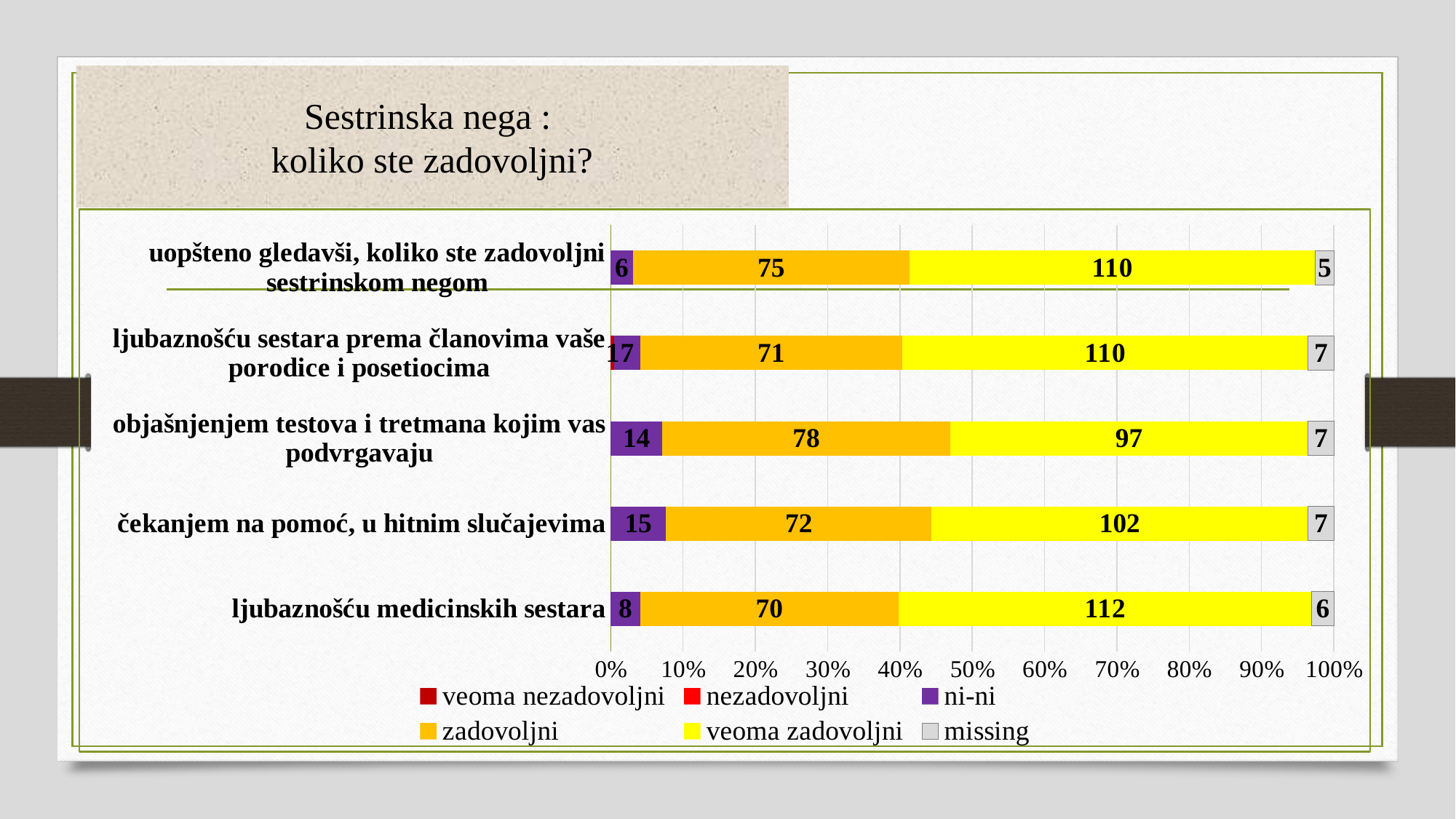
What is the 'missing' value for 'uopšteno gledavši, koliko ste zadovoljni sestrinskom negom'? 5 Which category has the lowest 'veoma zadovoljni' value? objašnjenjem testova i tretmana kojim vas podvrgavaju What is the value of 'zadovoljni' for 'objašnjenjem testova i tretmana kojim vas podvrgavaju'? 78 What is the difference between the 'zadovoljni' values for 'objašnjenjem testova i tretmana kojim vas podvrgavaju' and 'ljubaznošću medicinskih sestara'? 8 How many categories are shown on the chart? 5 What is the 'ni-ni' value for 'čekanjem na pomoć, u hitnim slučajevima'? 15 What is the total of the labelled values in the bar for 'ljubaznošću medicinskih sestara'? 196 What kind of chart is shown on the slide? Stacked bar chart Which has the larger 'zadovoljni' value: 'uopšteno gledavši, koliko ste zadovoljni sestrinskom negom' or 'čekanjem na pomoć, u hitnim slučajevima'? uopšteno gledavši, koliko ste zadovoljni sestrinskom negom What is the value of 'veoma zadovoljni' for 'ljubaznošću medicinskih sestara'? 112 Which category has the highest 'veoma zadovoljni' value? ljubaznošću medicinskih sestara How many series does the legend list? 6